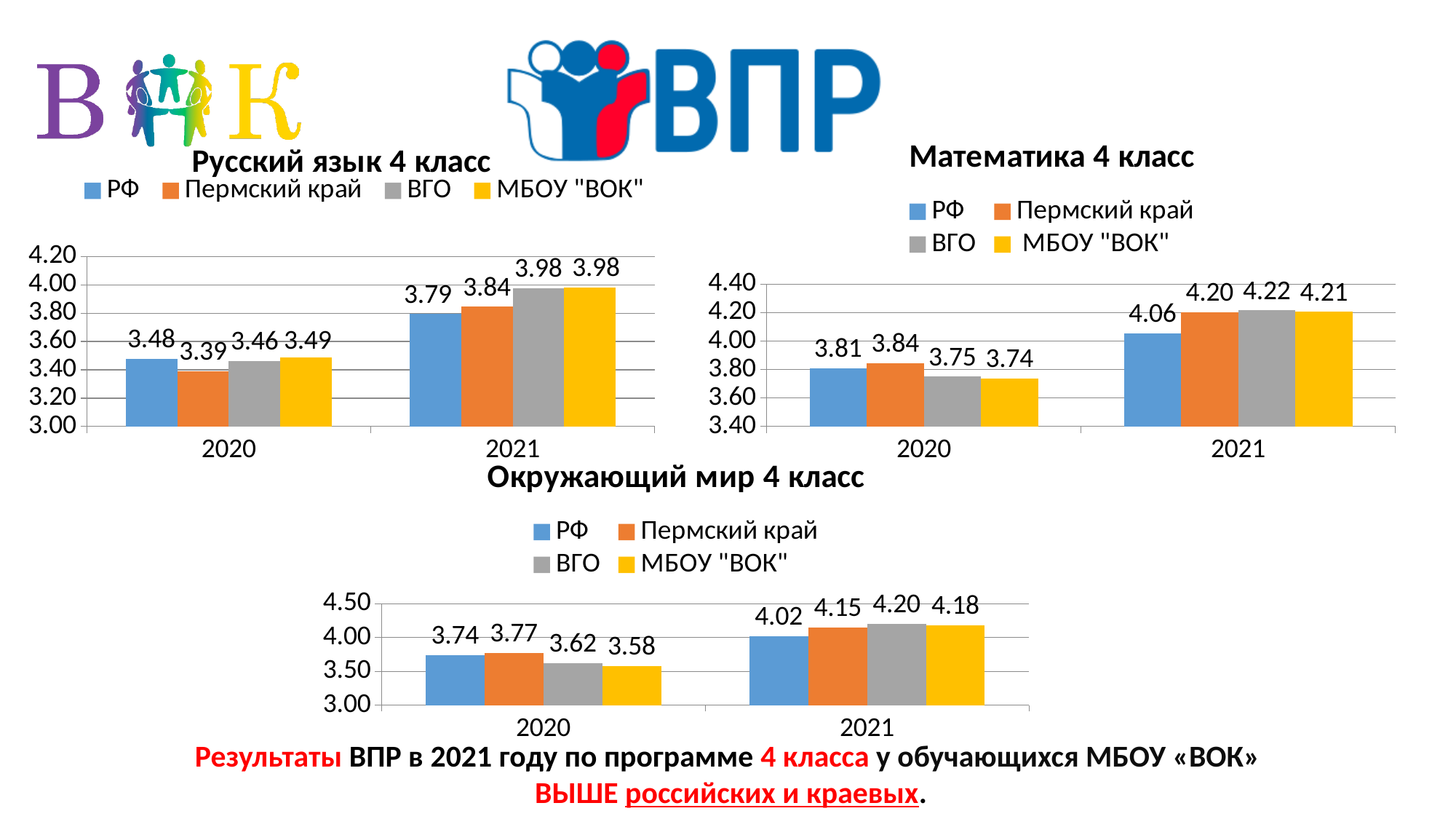
In the chart titled "Окружающий мир 4 класс", which series has the lowest value in 2020? МБОУ "ВОК" In the chart titled "Окружающий мир 4 класс", do the values for Пермский край rise or fall from 2020 to 2021? rise In the chart titled "Русский язык 4 класс", what is the difference between the МБОУ "ВОК" values for 2021 and 2020? 0.49 In the chart titled "Окружающий мир 4 класс", what is the value for ВГО in 2021? 4.20 How many series does the legend of the chart titled "Русский язык 4 класс" list? 4 In the chart titled "Математика 4 класс", what is the value for РФ in 2020? 3.81 What kind of chart is the chart titled "Математика 4 класс"? bar chart In the chart titled "Математика 4 класс", which is larger in 2021: the value for РФ or the value for Пермский край? Пермский край In the chart titled "Математика 4 класс", which series has the highest value in 2021? ВГО How many year categories are shown on the x axis of the chart titled "Русский язык 4 класс"? 2 In the chart titled "Русский язык 4 класс", what is the value for МБОУ "ВОК" in 2021? 3.98 In the chart titled "Окружающий мир 4 класс", is the value for РФ in 2021 greater or less than 4.00? greater